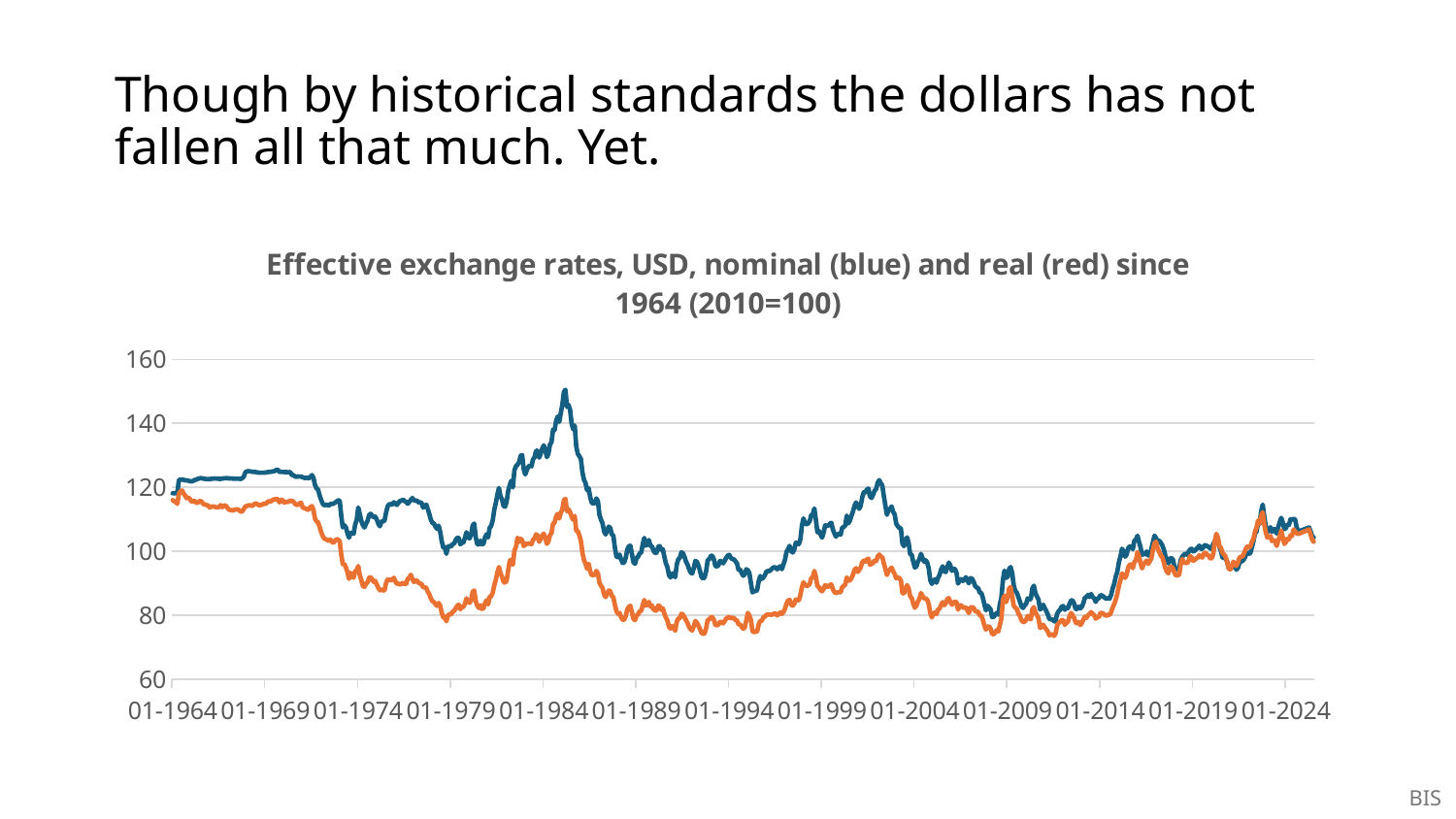
Is the peak value of the blue (nominal) line around 1985 greater or less than 140? greater Does the blue (nominal) line rise or fall between 01-1984 and 01-1989? fall Is the value of the red (real) line around 01-1969 greater or less than 100? greater Around 01-1984, which line is higher, the blue (nominal) or the red (real)? blue (nominal) Is the value of the red (real) line at its lowest point around 2011 greater or less than 80? less What is the title of the chart? Effective exchange rates, USD, nominal (blue) and real (red) since 1964 (2010=100) What is the highest value shown on the y axis? 160 How many lines (series) are plotted on the chart? 2 In which period does the blue (nominal) line reach its highest value? between 01-1984 and 01-1989 Which colour represents the nominal effective exchange rate? blue What kind of chart is shown on the slide? line chart